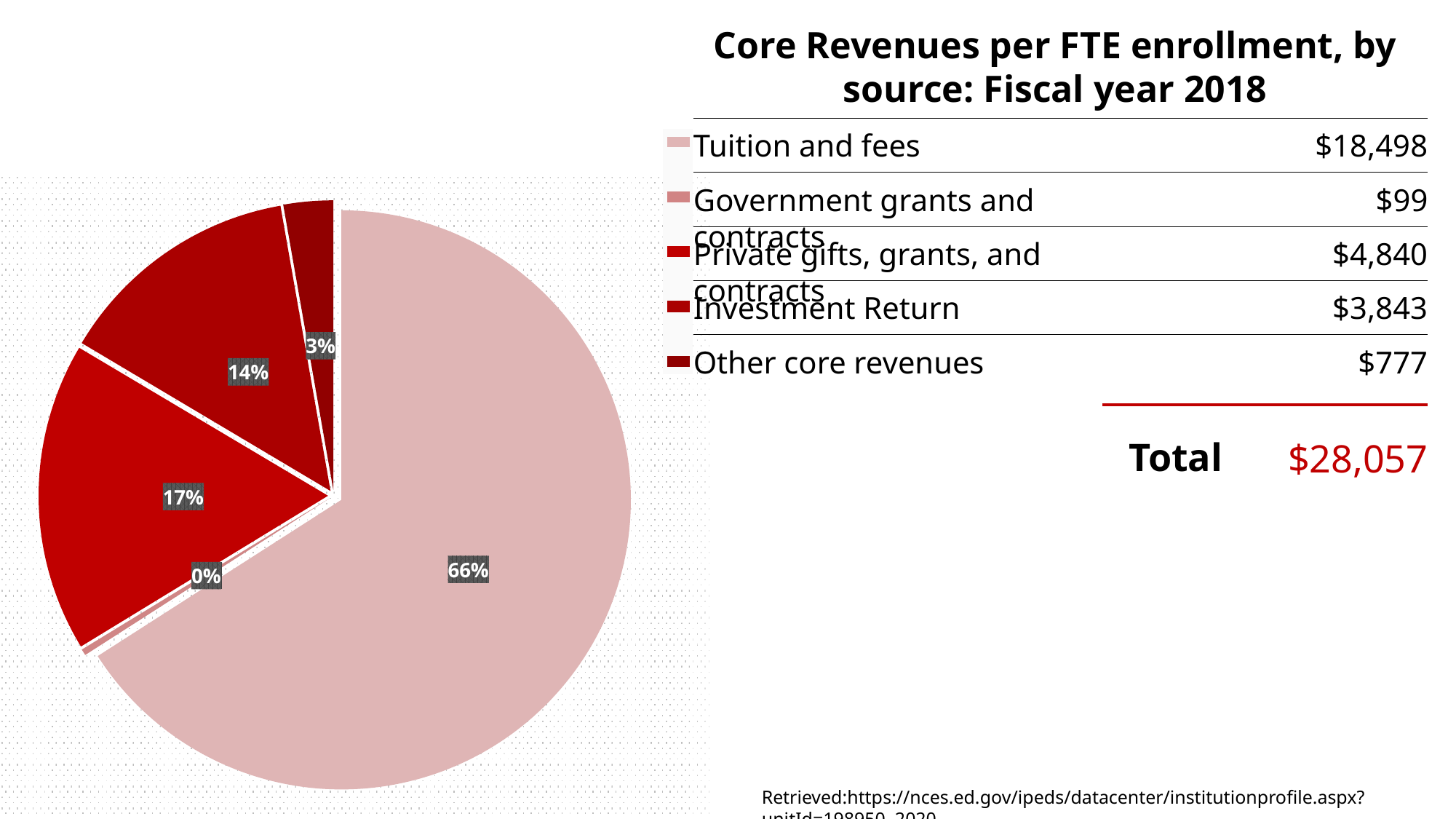
What is the value for Other core revenues? $777 What is the value for Tuition and fees? $18,498 Which is larger, Private gifts, grants, and contracts or Investment Return? Private gifts, grants, and contracts What is the value for Investment Return? $3,843 Which revenue source has the highest value? Tuition and fees How many revenue sources are shown in the pie chart? 5 What is the title of the chart? Core Revenues per FTE enrollment, by source: Fiscal year 2018 What is the total of all core revenues per FTE enrollment? $28,057 What is the difference between Private gifts, grants, and contracts and Investment Return? $997 What kind of chart is shown on the slide? pie chart What share of the pie does Tuition and fees represent? 66% Which revenue source has the lowest value? Government grants and contracts